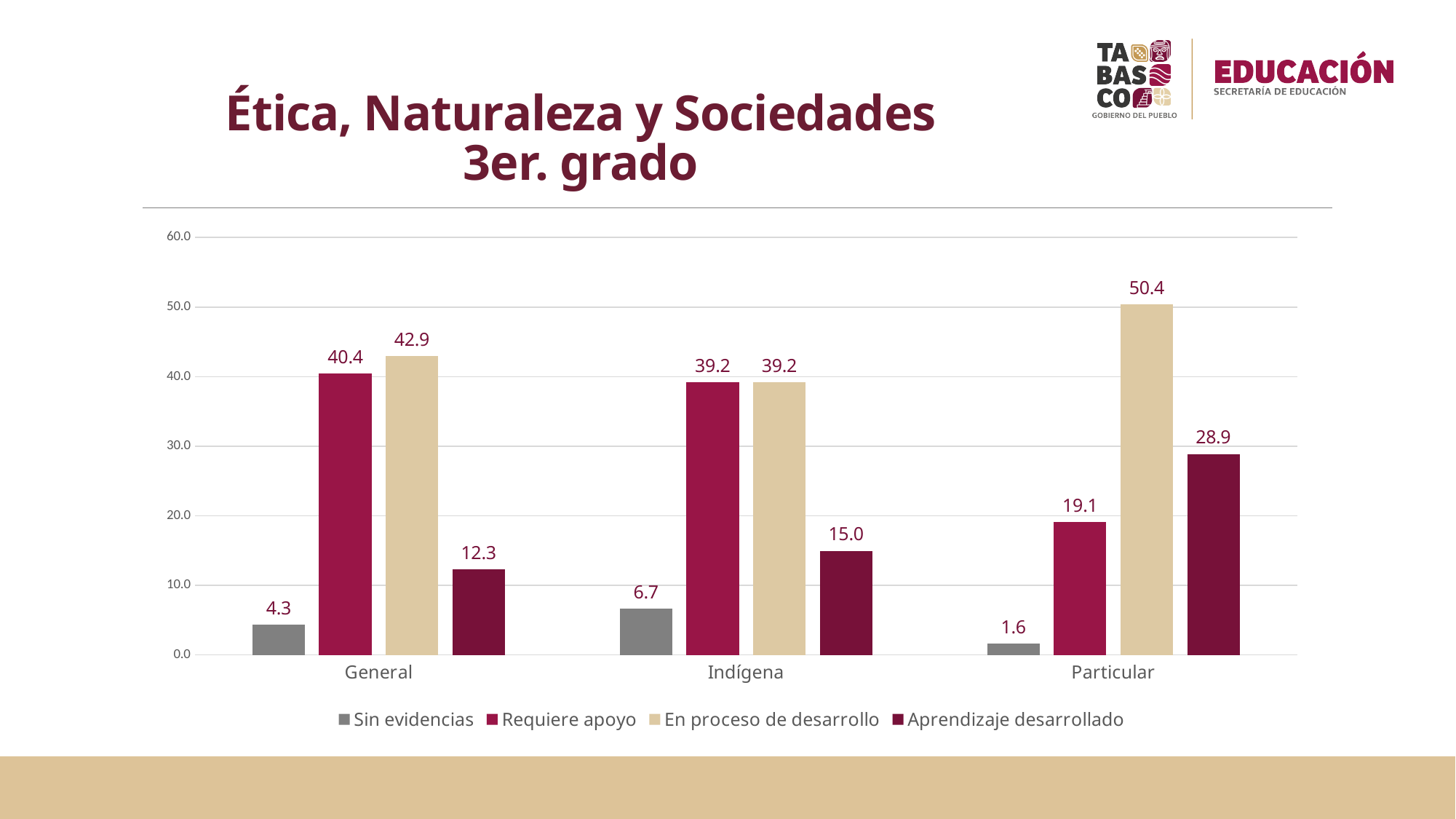
What kind of chart is shown on the slide? bar chart What is the value for "Sin evidencias" in the Indígena category? 6.7 How many categories are shown on the x axis? 3 Which category has the lowest value for "Sin evidencias"? Particular What is the difference between "Requiere apoyo" in General and "Requiere apoyo" in Particular? 21.3 What is the value for "En proceso de desarrollo" in the Particular category? 50.4 How many series does the legend list? 4 Is the value for "Aprendizaje desarrollado" in Particular greater or less than 30.0? less What is the value for "Aprendizaje desarrollado" in the General category? 12.3 Which is larger: "Requiere apoyo" in General or "En proceso de desarrollo" in General? En proceso de desarrollo What is the title of the slide? Ética, Naturaleza y Sociedades 3er. grado Which category has the highest value for "Aprendizaje desarrollado"? Particular